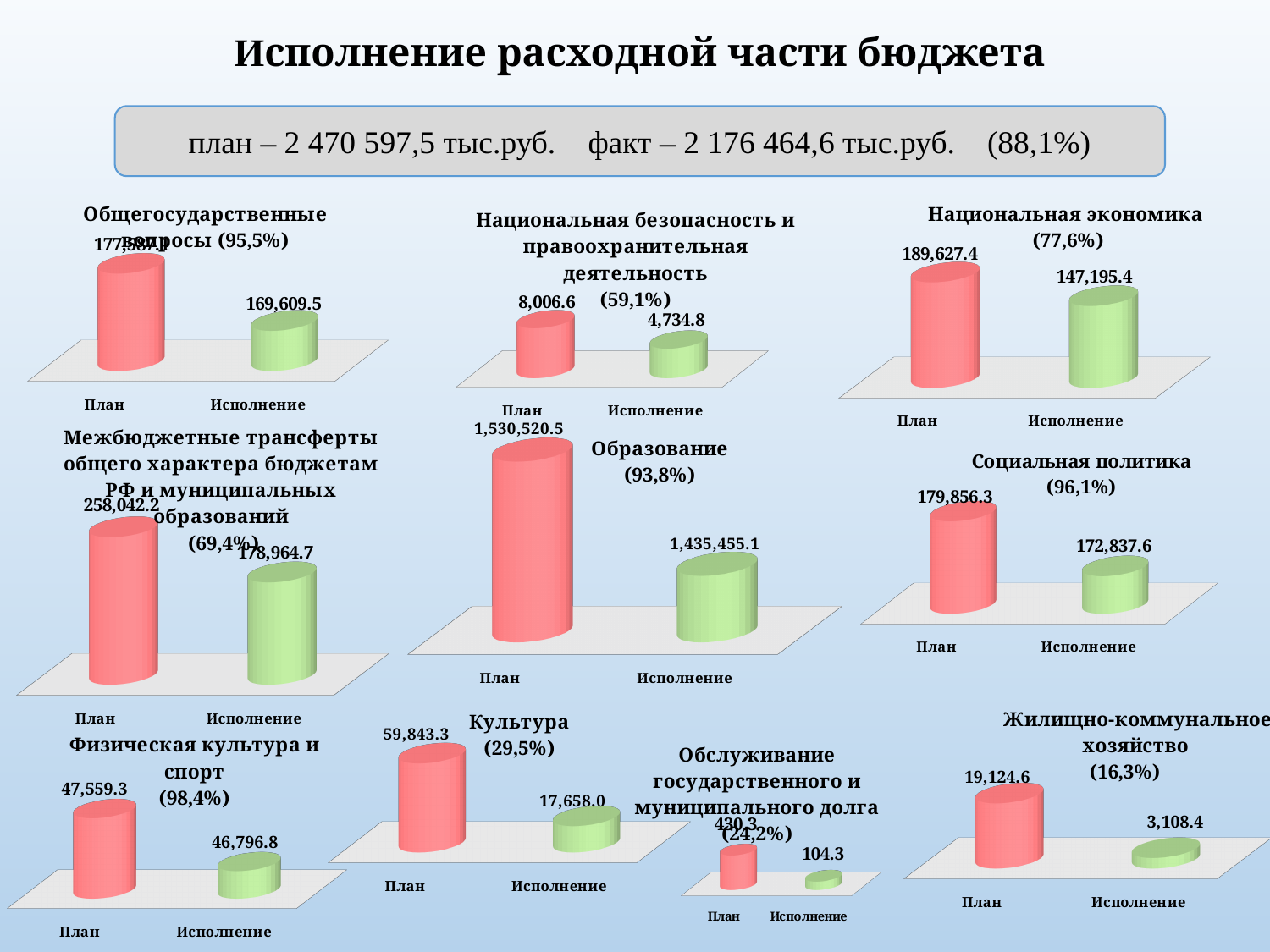
How many categories does the 'Образование' chart show? 2 In the 'Обслуживание государственного и муниципального долга' chart, what is the value for Исполнение? 104.3 In the 'Физическая культура и спорт' chart, what is the value for План? 47,559.3 In the 'Социальная политика' chart, what is the value for Исполнение? 172,837.6 In the 'Культура' chart, what is the difference between План and Исполнение? 42,185.3 In the 'Национальная экономика' chart, what is the value for План? 189,627.4 In the 'Образование' chart, what is the value for План? 1,530,520.5 What kind of chart is the 'Социальная политика' chart? bar chart What percentage is shown in the title of the 'Культура' chart? 29,5% In the 'Национальная экономика' chart, what is the value for Исполнение? 147,195.4 In the 'Национальная безопасность и правоохранительная деятельность' chart, what is the difference between План and Исполнение? 3,271.8 In the 'Жилищно-коммунальное хозяйство' chart, which is larger, План or Исполнение? План